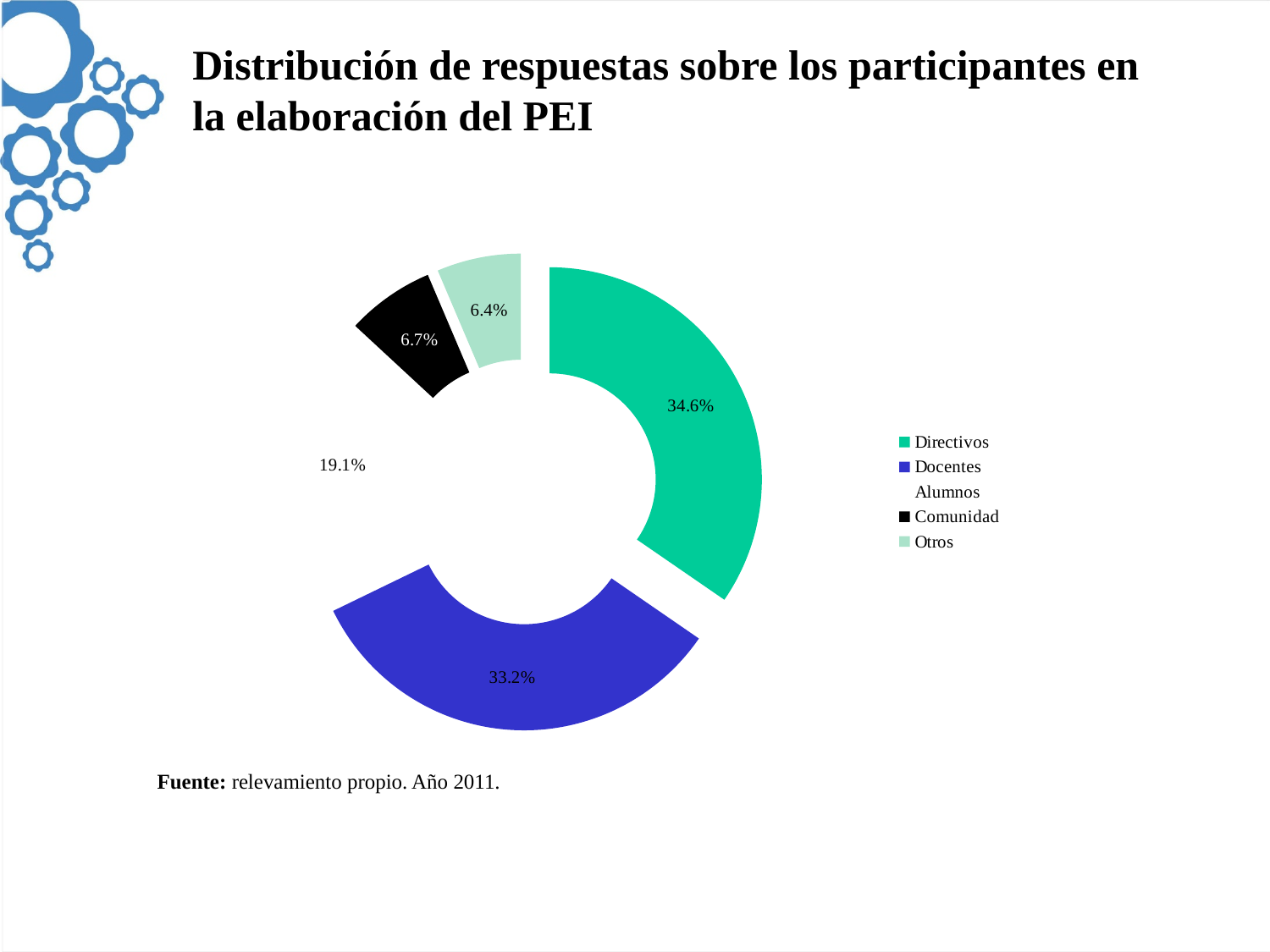
What percentage of responses corresponds to Docentes? 33.2% What percentage of responses corresponds to Otros? 6.4% What is the difference in percentage points between Directivos and Docentes? 1.4 percentage points What is the title of the chart on the slide? Distribución de respuestas sobre los participantes en la elaboración del PEI How many categories does the legend list? 5 Which category has the largest share of responses? Directivos Which has a larger share, Comunidad or Otros? Comunidad Which category has the smallest share of responses? Otros What percentage of responses corresponds to Directivos? 34.6% What type of chart is shown on the slide? Doughnut (pie) chart What percentage of responses corresponds to Comunidad? 6.7% What percentage of responses corresponds to Alumnos? 19.1%